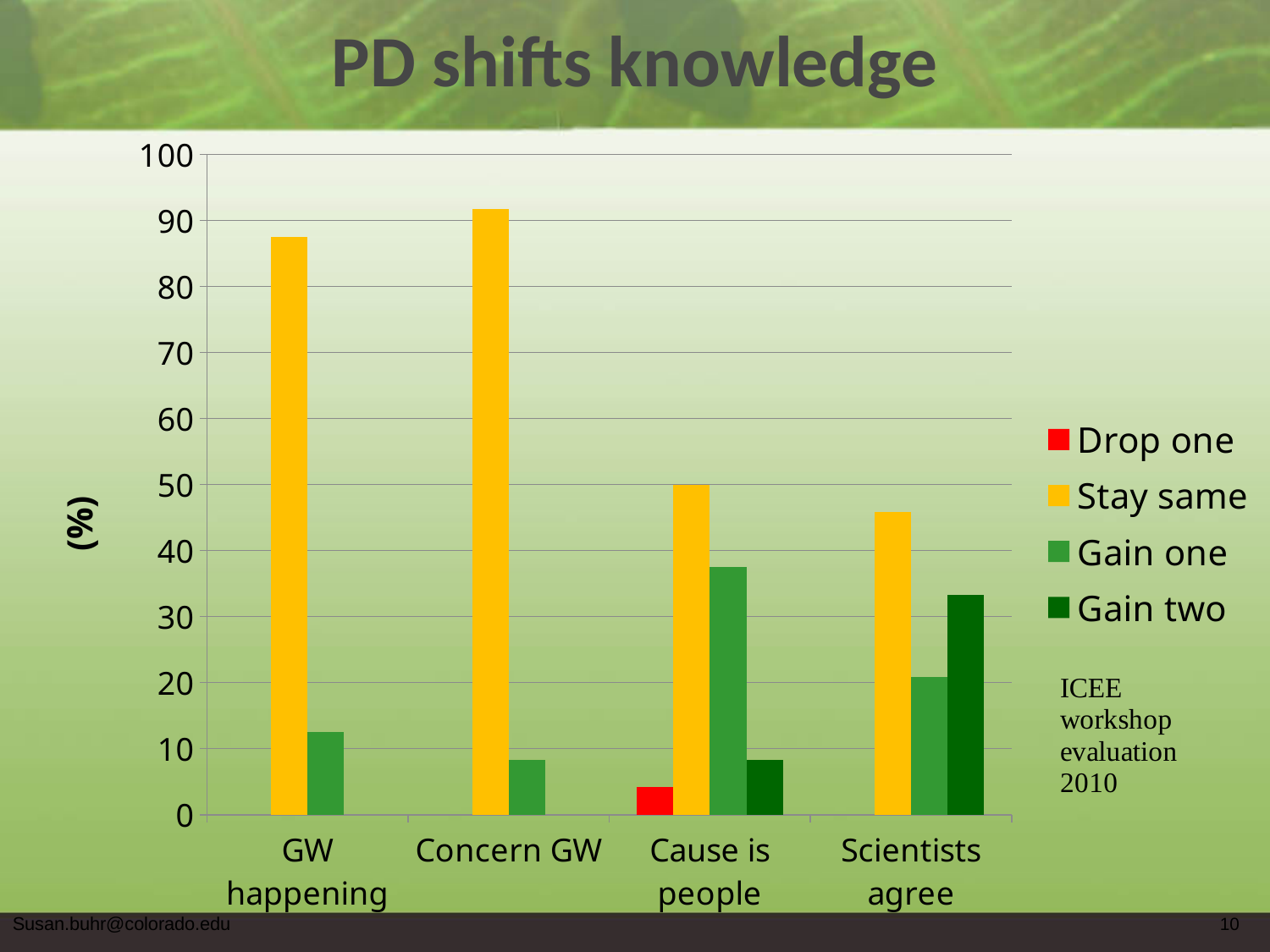
What kind of chart is shown on the slide? bar chart What is the label on the vertical axis of the chart? (%) Is the Stay same value for GW happening greater or less than 80? greater For Scientists agree, which is larger: Gain one or Gain two? Gain two Which category has the highest Stay same value? Concern GW What is the title of the chart on the slide? PD shifts knowledge How many series does the chart's legend list? 4 How many categories are shown on the x axis of the chart? 4 For Cause is people, which is larger: Gain one or Gain two? Gain one Is the Drop one value for Cause is people greater or less than 10? less Is the Gain one value for Cause is people greater or less than 30? greater Which category has the lowest Stay same value? Scientists agree